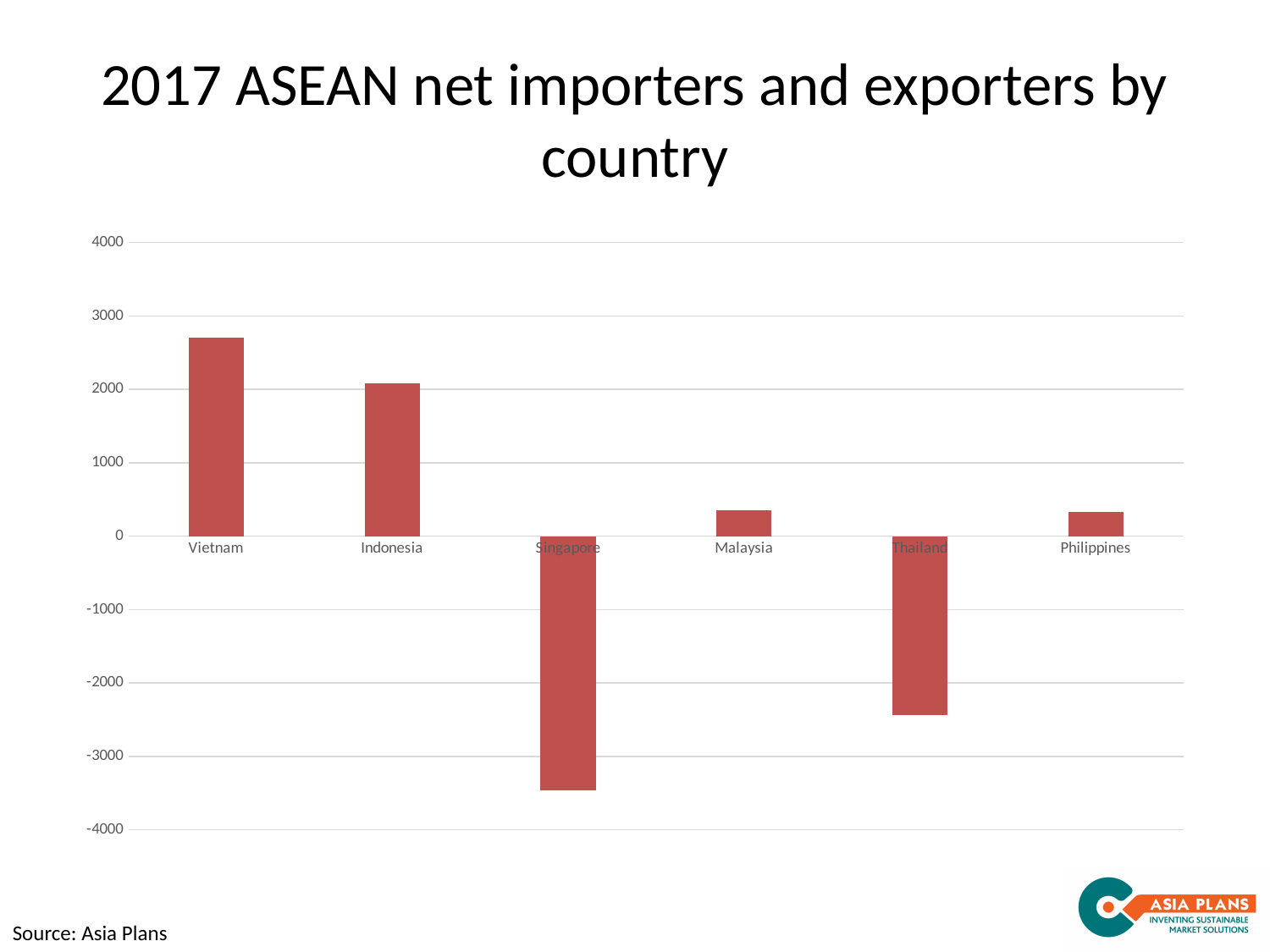
Which has the larger value, Vietnam or Indonesia? Vietnam Is the value for Malaysia greater or less than 1000? less Which has the larger value, Thailand or Singapore? Thailand Is the value for Thailand greater or less than -3000? greater Which country has the highest value on the chart? Vietnam What is the title of the chart on the slide? 2017 ASEAN net importers and exporters by country Is the value for Vietnam greater or less than 2000? greater Which country has the lowest value on the chart? Singapore What kind of chart is shown on the slide? bar chart How many countries are shown on the chart? 6